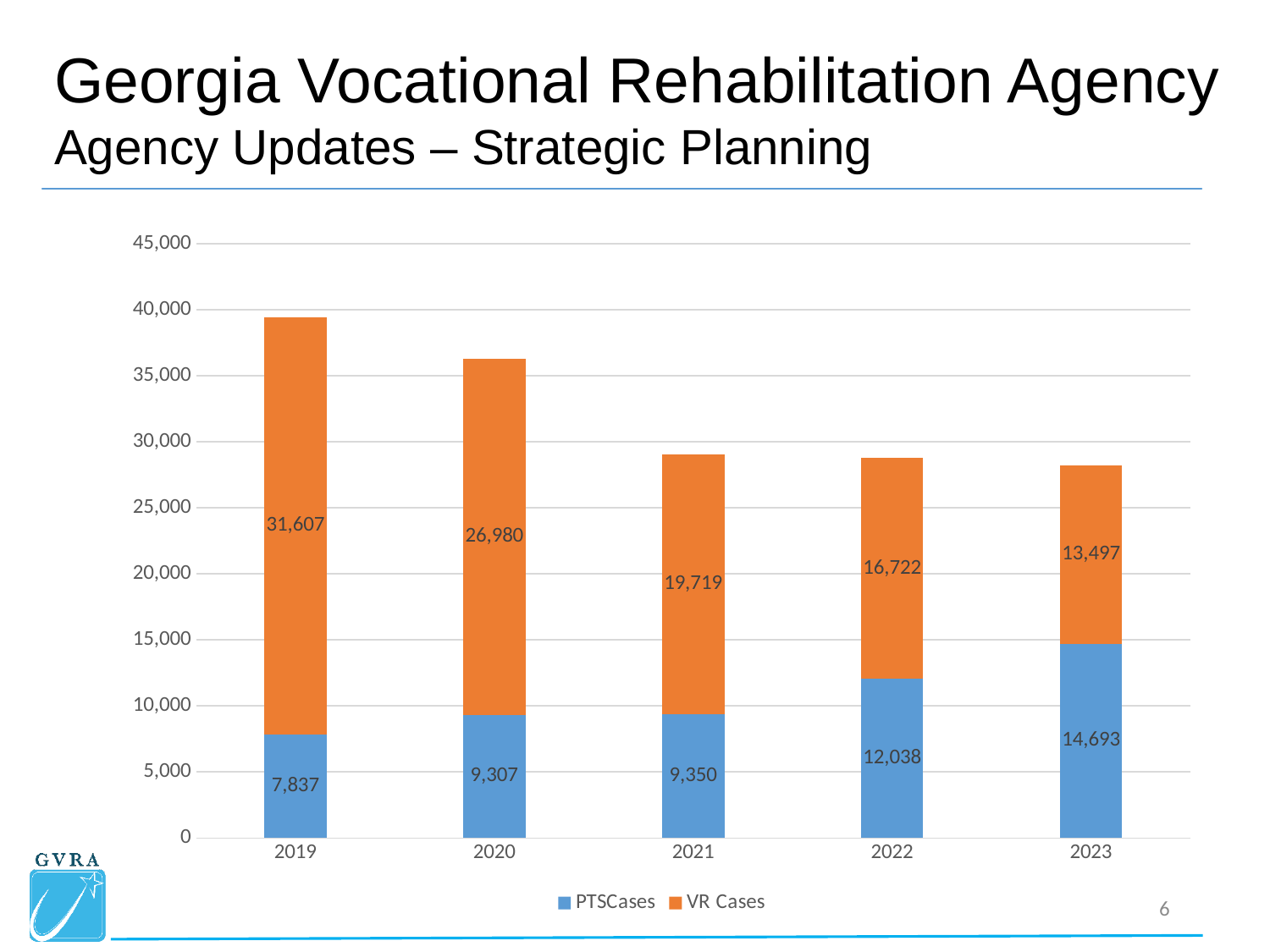
What kind of chart is shown on the slide? Stacked bar chart What is the value of PTSCases for 2023? 14,693 Which year has the lowest value for PTSCases? 2019 How many years are shown on the x axis? 5 How many series does the legend list? 2 Do the VR Cases values rise or fall from 2019 to 2023? Fall Which year has the highest value for VR Cases? 2019 What is the difference between VR Cases in 2019 and VR Cases in 2023? 18,110 What is the value of VR Cases for 2019? 31,607 Which is larger in 2023, PTSCases or VR Cases? PTSCases What is the value of PTSCases for 2021? 9,350 What is the total of the stacked bar for 2022? 28,760